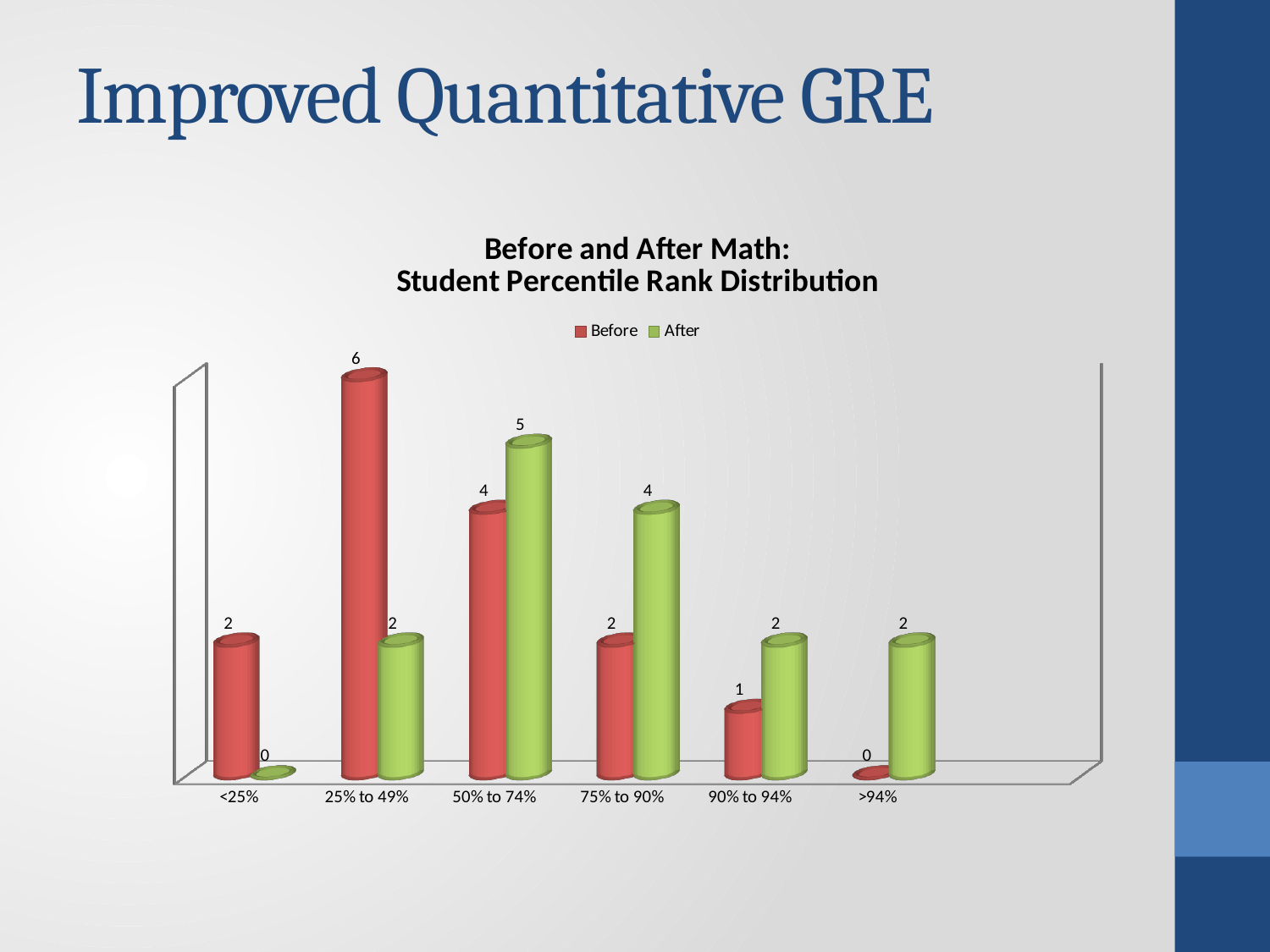
What is the title of the chart? Before and After Math: Student Percentile Rank Distribution What is the Before value for the 25% to 49% category? 6 What is the Before value for the 90% to 94% category? 1 Which category has the highest Before value? 25% to 49% What is the difference between the Before and After values for the 75% to 90% category? 2 How many series does the legend list? 2 Which category has the lowest After value? <25% What is the After value for the <25% category? 0 What kind of chart is shown on the slide? Bar chart For the >94% category, which is larger, the Before value or the After value? After How many categories are shown on the x axis? 6 What is the After value for the 50% to 74% category? 5